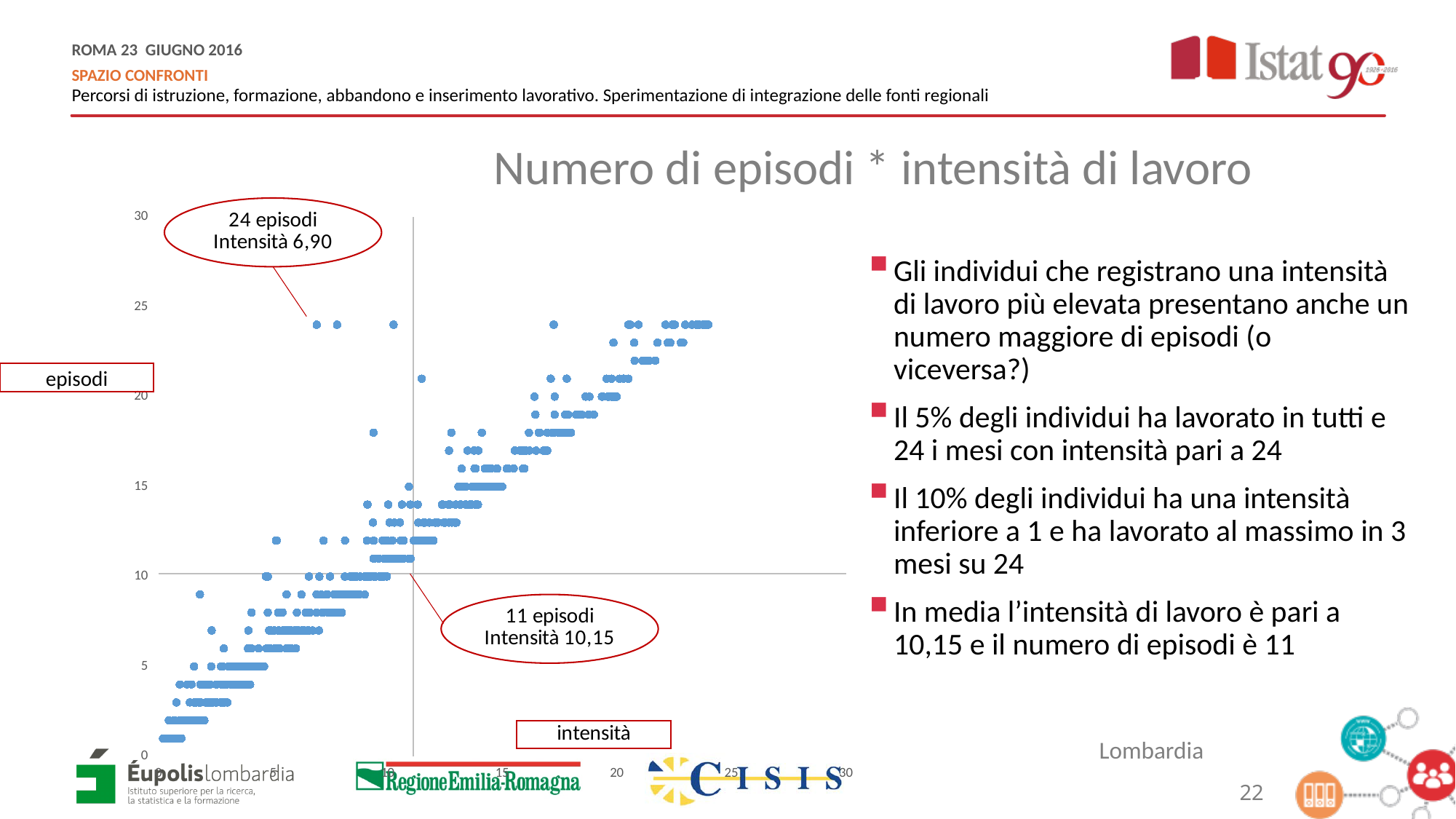
According to the callout on the chart, how many episodi correspond to the intensity of 10,15? 11 What is the difference in episodi between the two annotated points (24 episodi and 11 episodi)? 13 According to the callout on the chart, what is the intensity of the point annotated with 24 episodi? 6,90 Is the highest number of episodi plotted on the chart greater or less than 25? less Do the number of episodi generally rise or fall as intensità increases along the x axis? rise What is the title of the chart? Numero di episodi * intensità di lavoro What label is given to the vertical axis of the chart? episodi What is the maximum value shown on the vertical (episodi) axis? 30 Which has more episodi: the point annotated with intensità 6,90 or the point annotated with intensità 10,15? the point with intensità 6,90 What kind of chart is shown on the slide? scatter chart